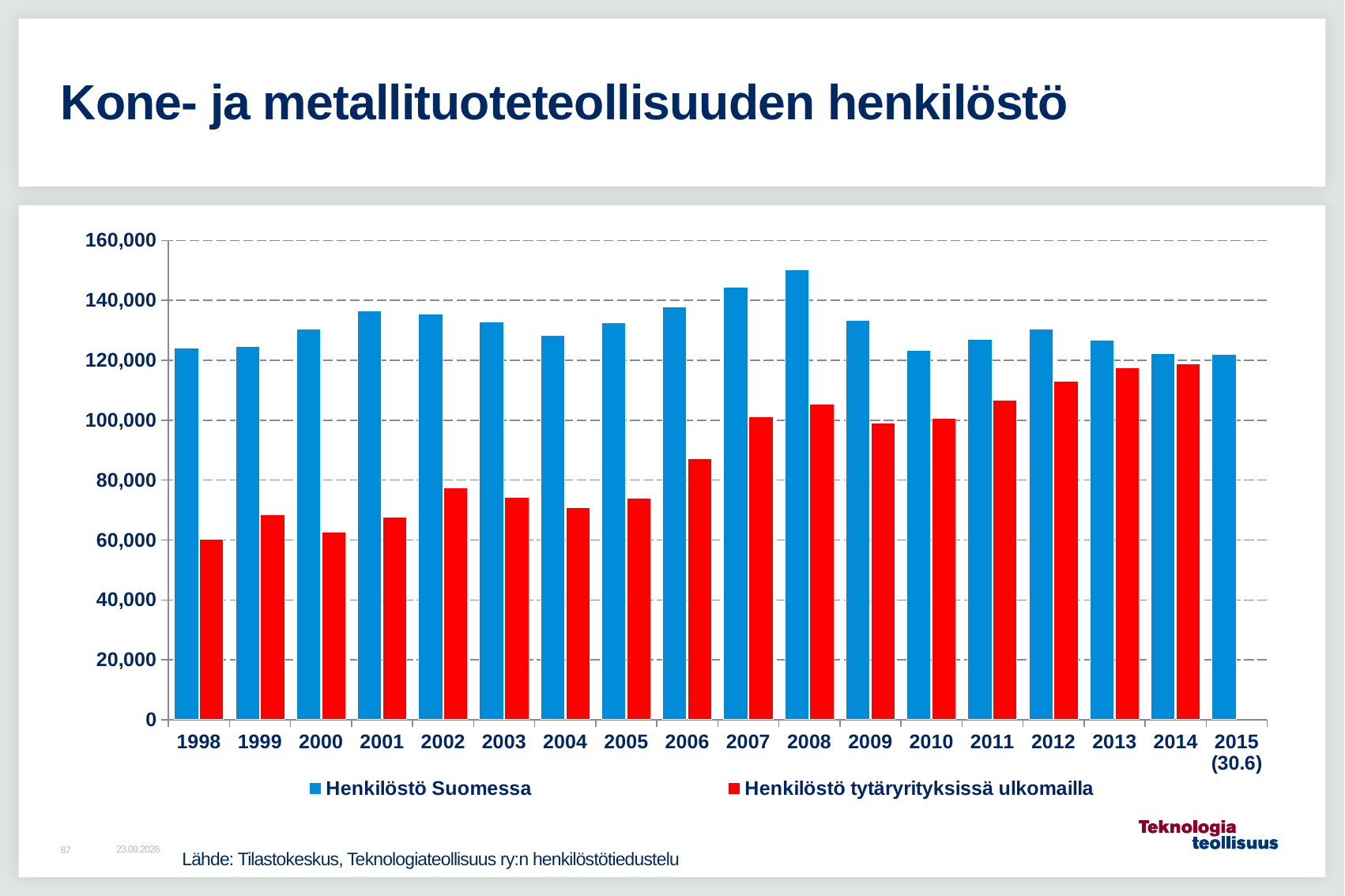
Is the value for Henkilöstö tytäryrityksissä ulkomailla in 2012 greater or less than 100,000? greater Is the value for Henkilöstö Suomessa in 2008 greater or less than 140,000? greater What kind of chart is shown on the slide? bar chart Is the value for Henkilöstö Suomessa in 2001 greater or less than 140,000? less Which is larger: Henkilöstö Suomessa in 2007 or in 2001? 2007 Which colour represents Henkilöstö Suomessa in the chart? blue How many years (categories) are shown on the x axis? 18 Does the value for Henkilöstö tytäryrityksissä ulkomailla generally rise or fall from 1998 to 2014? rise In which year is the value for Henkilöstö tytäryrityksissä ulkomailla lowest? 1998 How many series does the legend list? 2 In which year is the value for Henkilöstö Suomessa highest? 2008